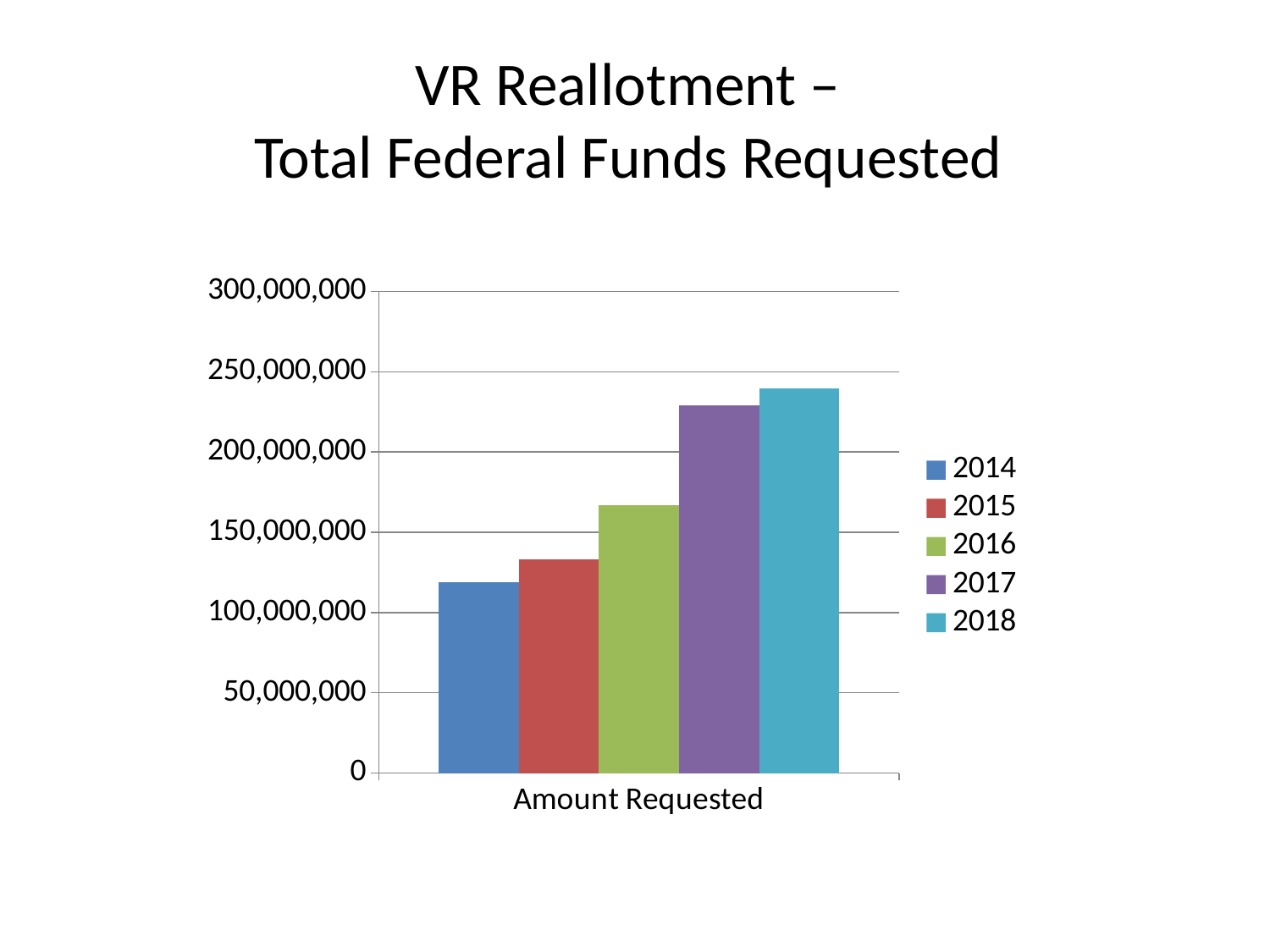
How many categories are shown on the x axis? 1 What is the label on the x axis of the chart? Amount Requested What kind of chart is shown on the slide? Bar chart Which is larger, the amount requested for 2017 or for 2016? 2017 Do the amounts requested rise or fall from 2014 to 2018? Rise Which year has the lowest amount requested? 2014 Is the value for 2018 greater or less than 250,000,000? less Which year has the highest amount requested? 2018 Is the value for 2017 greater or less than 200,000,000? greater Is the value for 2014 greater or less than 100,000,000? greater How many series does the legend list? 5